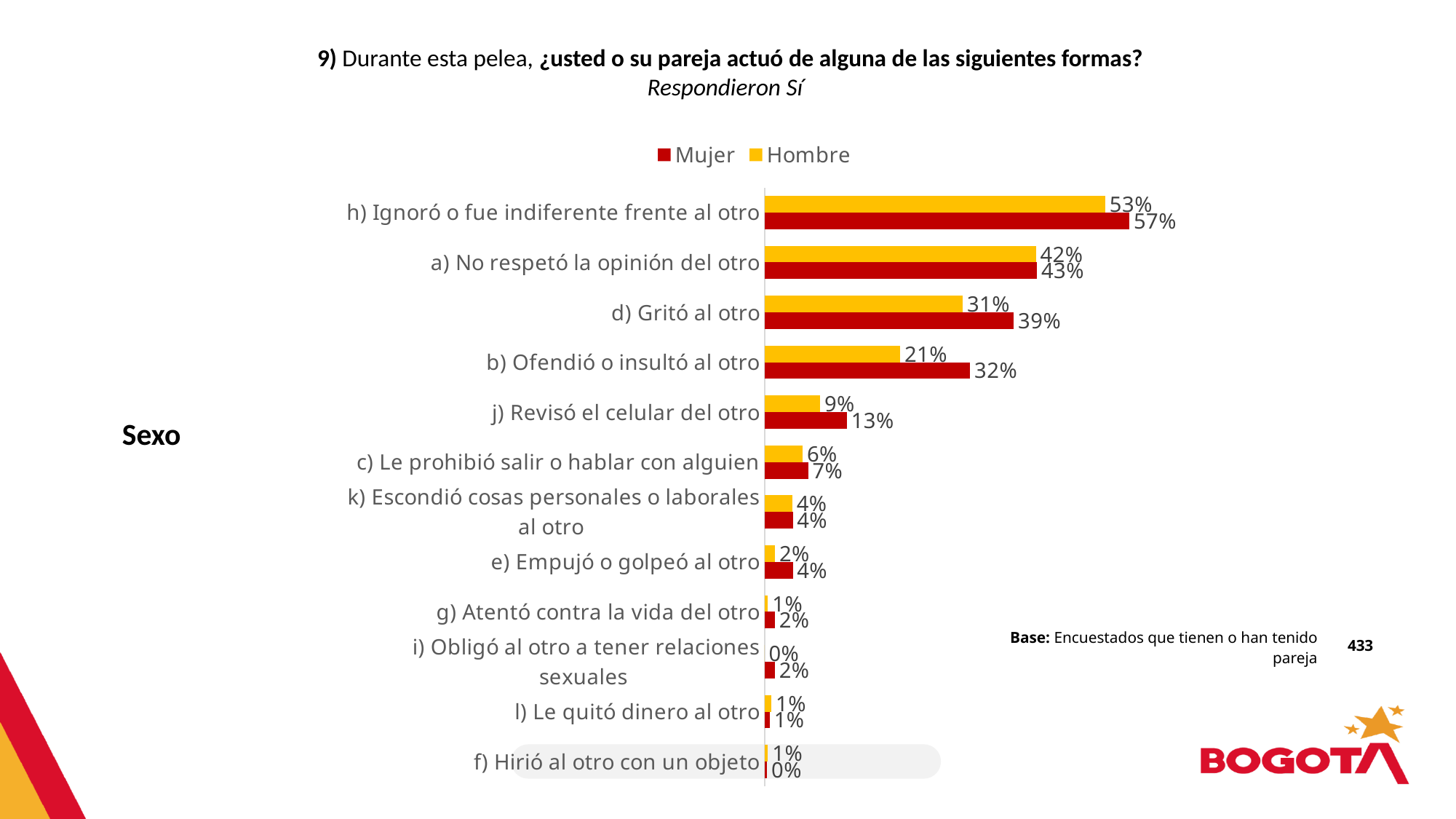
What type of chart is shown on the slide? Bar chart What is the Hombre value for "b) Ofendió o insultó al otro"? 21% Which colour represents the Hombre series in the chart? Yellow How many series does the legend list? 2 Which category has the highest Mujer value? h) Ignoró o fue indiferente frente al otro What is the Hombre value for "i) Obligó al otro a tener relaciones sexuales"? 0% What is the difference between the Mujer and Hombre values for "b) Ofendió o insultó al otro"? 11% For "j) Revisó el celular del otro", which series has the larger value, Mujer or Hombre? Mujer How many categories are shown in the chart? 12 What is the difference between the Mujer and Hombre values for "d) Gritó al otro"? 8% What is the Mujer value for "h) Ignoró o fue indiferente frente al otro"? 57% What is the Hombre value for "d) Gritó al otro"? 31%